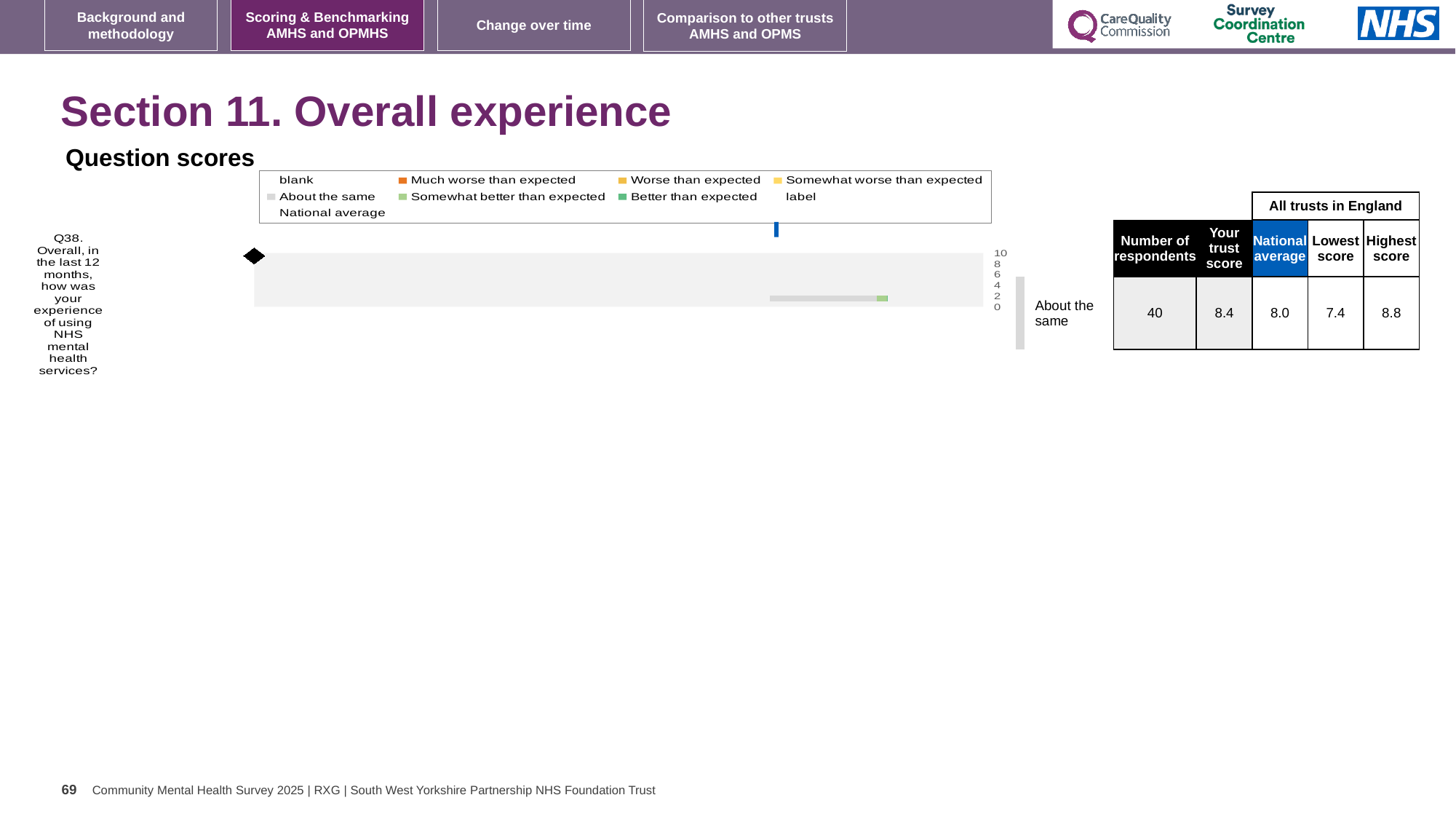
What is the national average score for Q38? 8.0 What is the difference between the trust's score and the national average for Q38? 0.4 Which question is plotted in the Question scores chart? Q38. Overall, in the last 12 months, how was your experience of using NHS mental health services? What is the highest score among all trusts in England for Q38? 8.8 Which is larger for Q38: the trust's score or the national average? the trust's score What kind of chart is shown under 'Question scores'? bar chart What is the trust's score for Q38 shown next to the chart? 8.4 How many questions (categories) are plotted in the Question scores chart? 1 What is the lowest score among all trusts in England for Q38? 7.4 What is the difference between the highest and lowest scores for Q38 across all trusts in England? 1.4 Which benchmark category is the trust's Q38 score placed in? About the same How many respondents answered Q38? 40